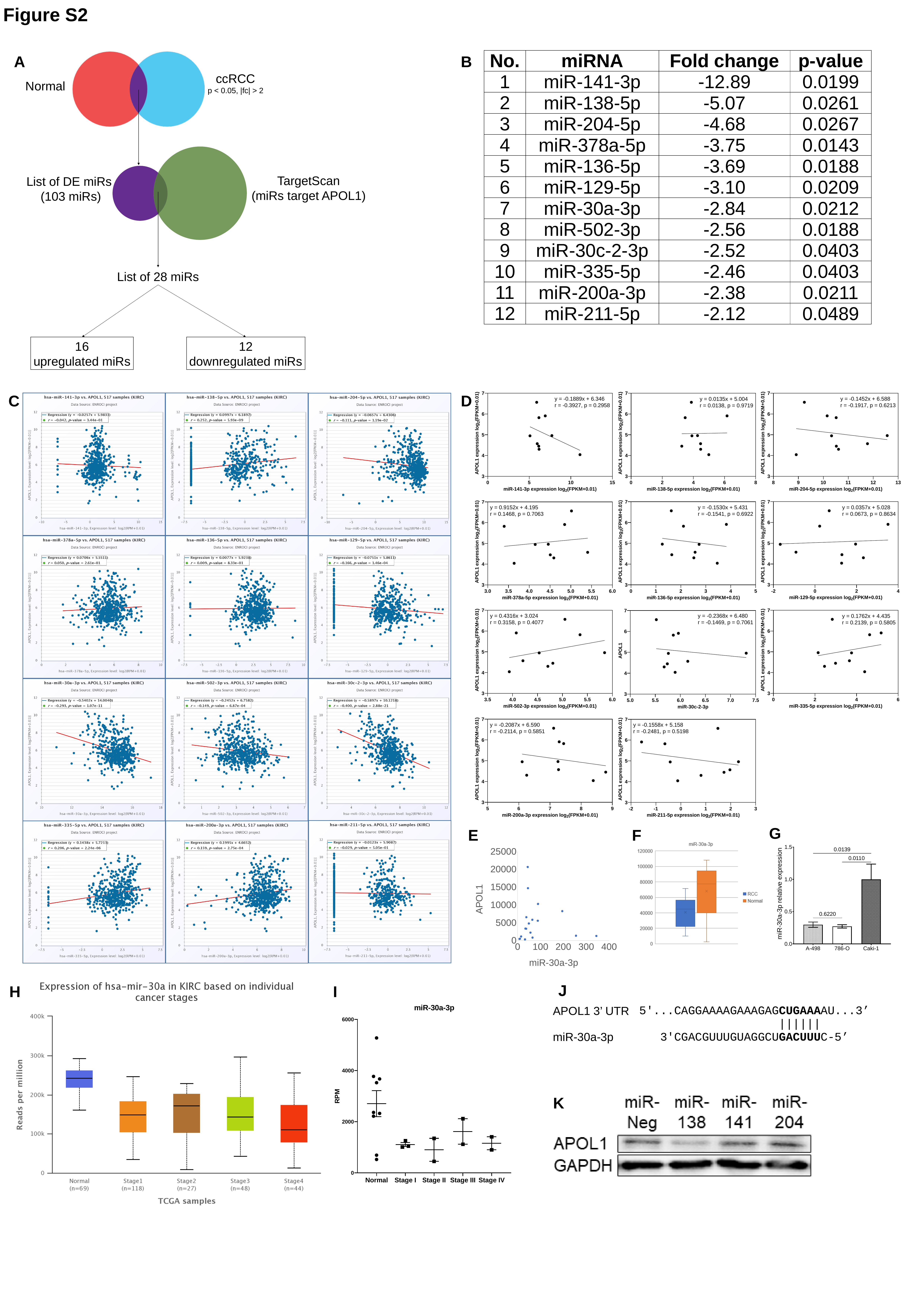
In the table in panel B, what is the fold change for miR-141-3p? -12.89 In the bar chart in panel G, is the value for A-498 greater or less than 0.5? less In the table in panel B, what is the p-value for miR-211-5p? 0.0489 In the box plot in panel H, what is the sample size (n) for Stage1? 118 In the box plot in panel F, how many series does the legend list? 2 In the table in panel B, which miRNA has the lowest (most negative) fold change? miR-141-3p In panel D, what is the r value printed on the miR-141-3p vs APOL1 scatter plot? -0.3927 What kind of chart is panel G? bar chart In the box plot in panel H, how many sample groups are shown on the x axis? 5 In the bar chart in panel G, which cell line has the highest miR-30a-3p relative expression? Caki-1 In the box plot in panel H, which group has the highest median reads per million? Normal In the bar chart in panel G, how many cell lines are shown on the x axis? 3